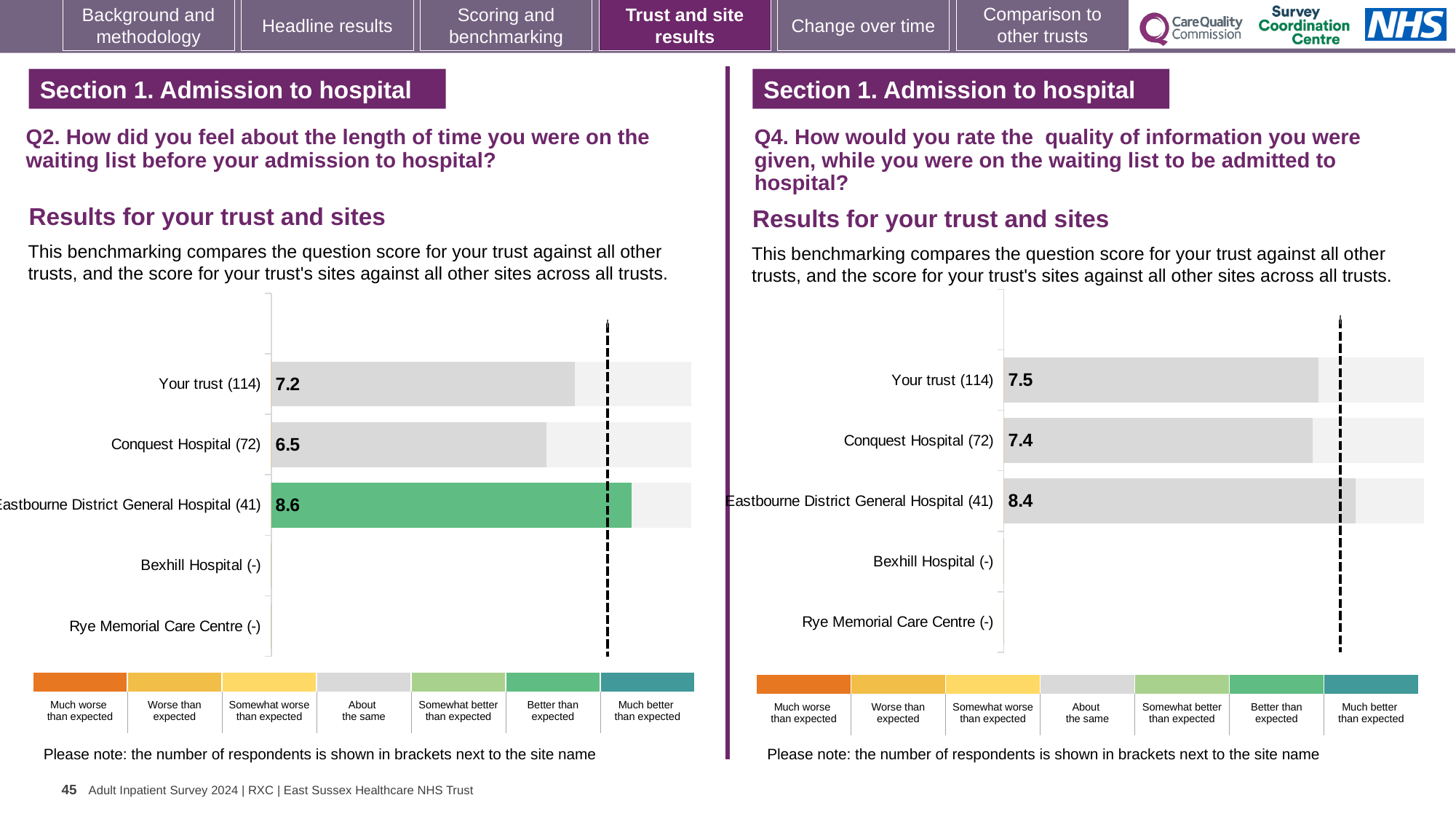
On the Q4 chart (right), what is the score for Eastbourne District General Hospital (41)? 8.4 On the Q2 chart (left), what is the difference between the scores for Eastbourne District General Hospital and Conquest Hospital? 2.1 On the Q4 chart (right), what is the difference between the scores for Your trust and Conquest Hospital? 0.1 On the Q2 chart (left), which is larger: the score for Your trust or the score for Conquest Hospital? Your trust On the Q2 chart (left), what is the score for Your trust (114)? 7.2 On the Q2 chart (left), which bar is coloured green? Eastbourne District General Hospital (41) What kind of chart is used on the Q4 chart (right)? Bar chart How many site/trust rows are listed on the Q2 chart (left)? 5 On the Q4 chart (right), what is the score for Your trust (114)? 7.5 On the Q4 chart (right), which of the three scored rows has the lowest score? Conquest Hospital (72) On the Q2 chart (left), which site has the highest score? Eastbourne District General Hospital (41) On the Q2 chart (left), what is the score for Conquest Hospital (72)? 6.5